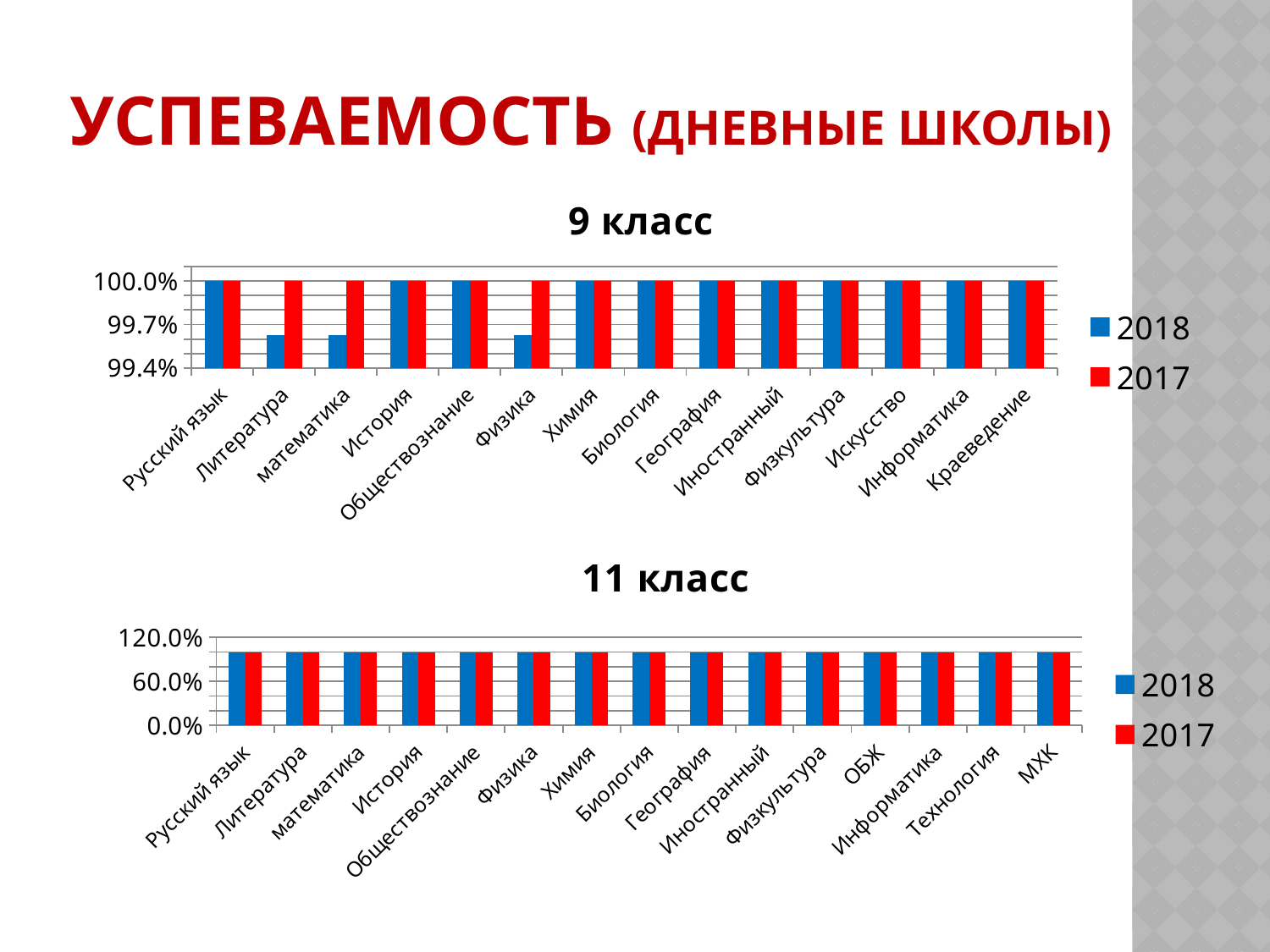
In the "9 класс" chart, is the 2018 value for Литература greater or less than 99.7%? less How many series does the legend of the "11 класс" chart list? 2 How many categories are shown on the x axis of the "11 класс" chart? 15 In the "11 класс" chart, is the 2018 value for Русский язык greater or less than 60.0%? greater How many categories are shown on the x axis of the "9 класс" chart? 14 In the "9 класс" chart, is the 2018 value for Физика greater or less than 99.7%? less What are the two legend entries of the "11 класс" chart? 2018 and 2017 In the "9 класс" chart, which is larger for математика, the 2018 value or the 2017 value? 2017 What kind of chart is the "9 класс" chart? bar chart In the "9 класс" chart, what is the 2017 value for Русский язык? 100.0% In the "9 класс" chart, which series is shown in blue? 2018